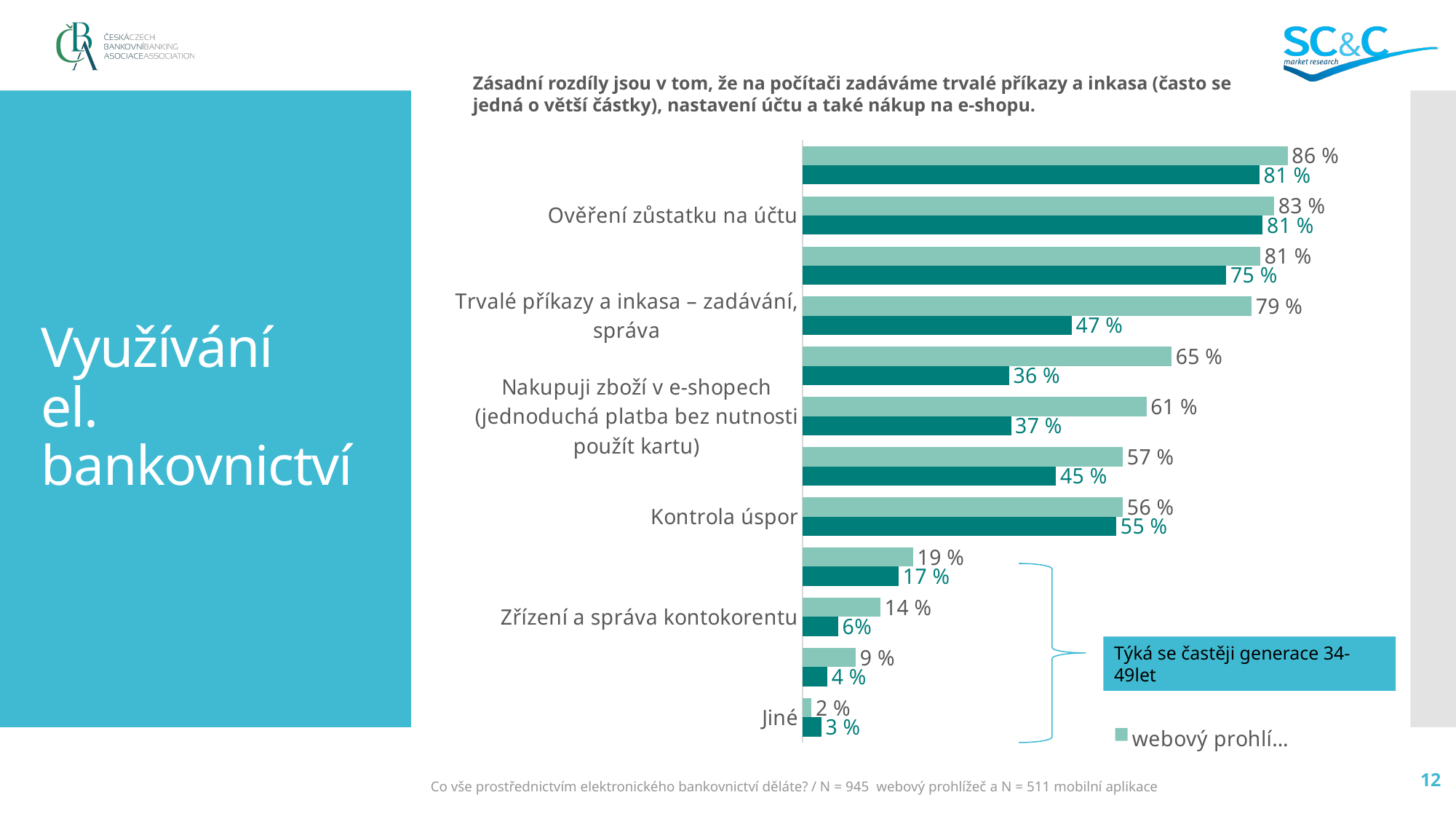
What is the largest value labelled on the chart? 86 % For "Trvalé příkazy a inkasa – zadávání, správa", how many percentage points higher is the light teal bar than the dark teal bar? 32 What is the value of the light teal bar for "Kontrola úspor"? 56 % What is the value of the dark teal bar for "Trvalé příkazy a inkasa – zadávání, správa"? 47 % For "Jiné", which bar is larger, the light teal or the dark teal one? dark teal For "Nakupuji zboží v e-shopech (jednoduchá platba bez nutnosti použít kartu)", what is the difference between the light teal bar (61 %) and the dark teal bar (37 %)? 24 How many pairs of bars are plotted on the chart? 12 What is the value of the dark teal bar for "Jiné"? 3 % What is the value of the dark teal bar for "Ověření zůstatku na účtu"? 81 % What kind of chart is shown on the slide? bar chart What is the value of the light teal bar for "Ověření zůstatku na účtu"? 83 % What is the value of the light teal bar for "Zřízení a správa kontokorentu"? 14 %